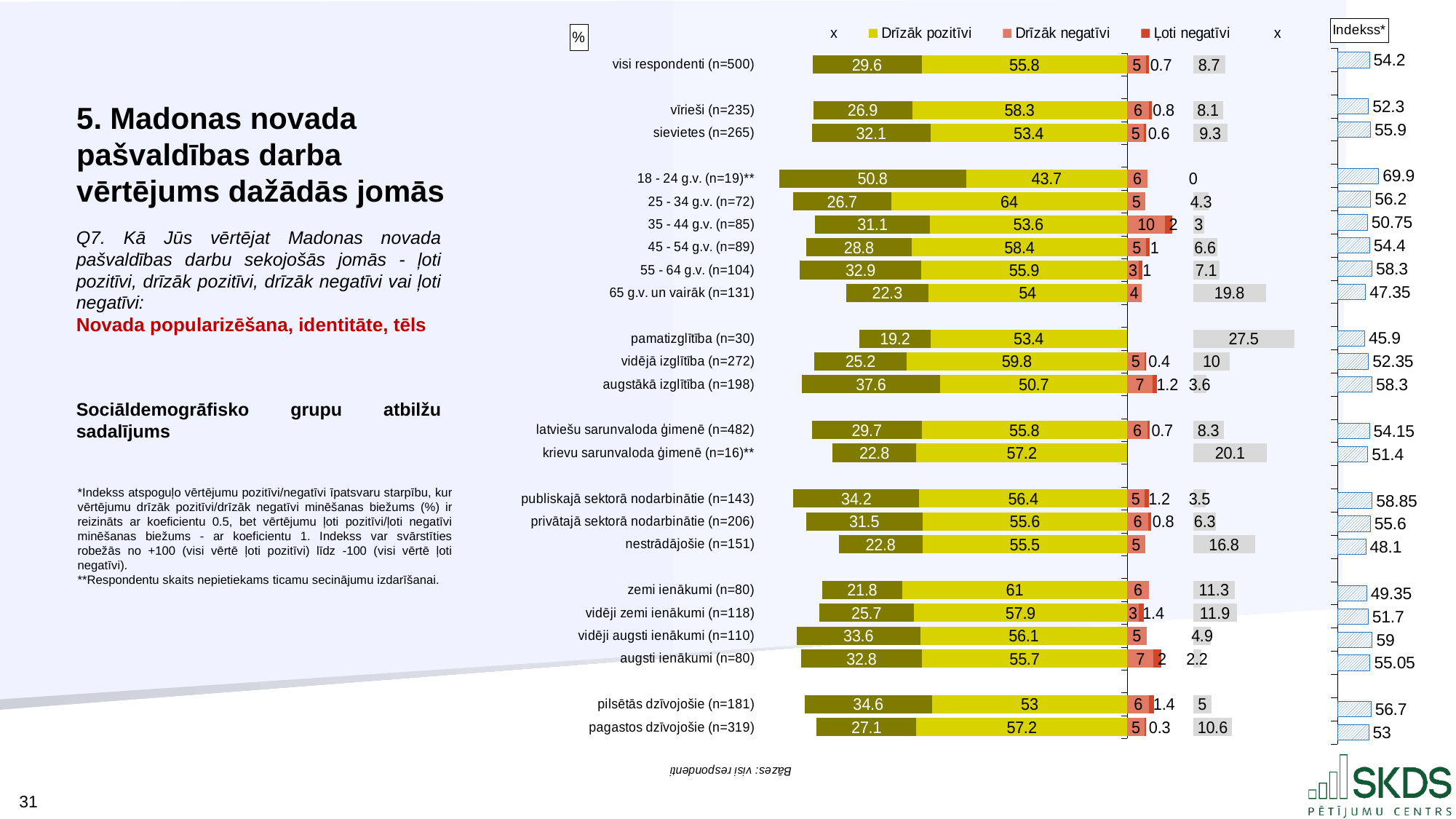
Which group has the lowest Indekss* value? pamatizglītība (n=30) What is the difference between the Indekss* values for visi respondenti (n=500) and vīrieši (n=235)? 1.9 What is the Indekss* value for 18 - 24 g.v. (n=19)**? 69.9 What is the value of the grey segment for pamatizglītība (n=30)? 27.5 Which group has the highest Drīzāk pozitīvi value? 25 - 34 g.v. (n=72) How many respondent groups are listed in the chart? 23 What is the value of the first (dark olive) segment for augstākā izglītība (n=198)? 37.6 Which group has the highest Indekss* value? 18 - 24 g.v. (n=19)** What is the Drīzāk pozitīvi value for visi respondenti (n=500)? 55.8 Which group has the larger Drīzāk pozitīvi value: 25 - 34 g.v. (n=72) or 65 g.v. un vairāk (n=131)? 25 - 34 g.v. (n=72) What kind of chart is used to show the responses by group? Stacked bar chart What is the difference between the Drīzāk pozitīvi values for vīrieši (n=235) and sievietes (n=265)? 4.9